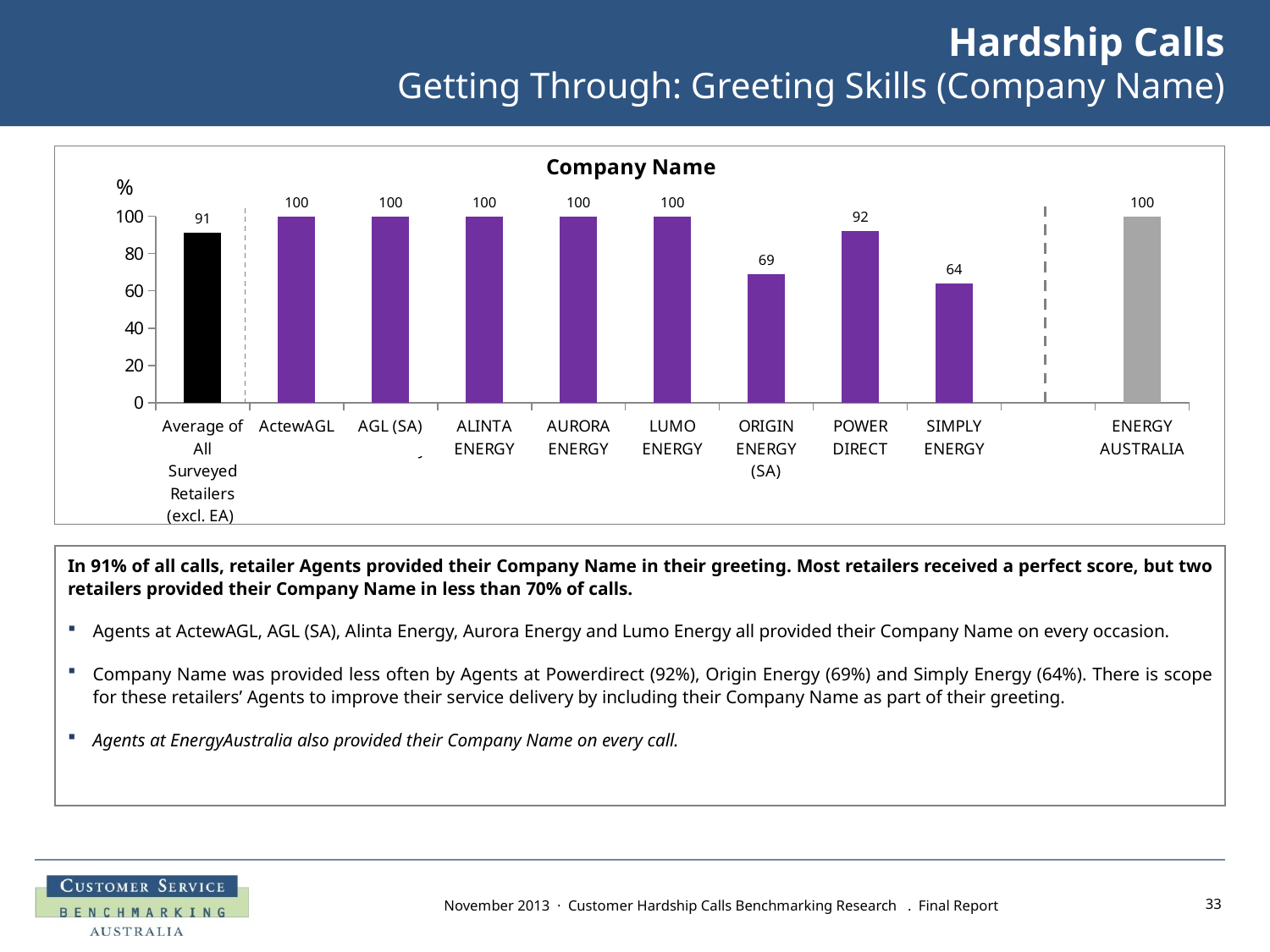
Is the value for Simply Energy greater or less than 80? less Which retailer has the lowest value in the Company Name chart? Simply Energy What is the difference between the values for Power Direct and Simply Energy in the Company Name chart? 28 What type of chart is shown on the slide? Bar chart What is the value for the Average of All Surveyed Retailers (excl. EA) in the Company Name chart? 91 What is the title of the chart on the slide? Company Name What is the value for Power Direct in the Company Name chart? 92 Which is larger in the Company Name chart, the value for Origin Energy (SA) or the value for Power Direct? Power Direct What is the value for Simply Energy in the Company Name chart? 64 What is the value for Origin Energy (SA) in the Company Name chart? 69 What is the difference between the value for ActewAGL and the Average of All Surveyed Retailers (excl. EA)? 9 How many bars are shown in the Company Name chart? 10